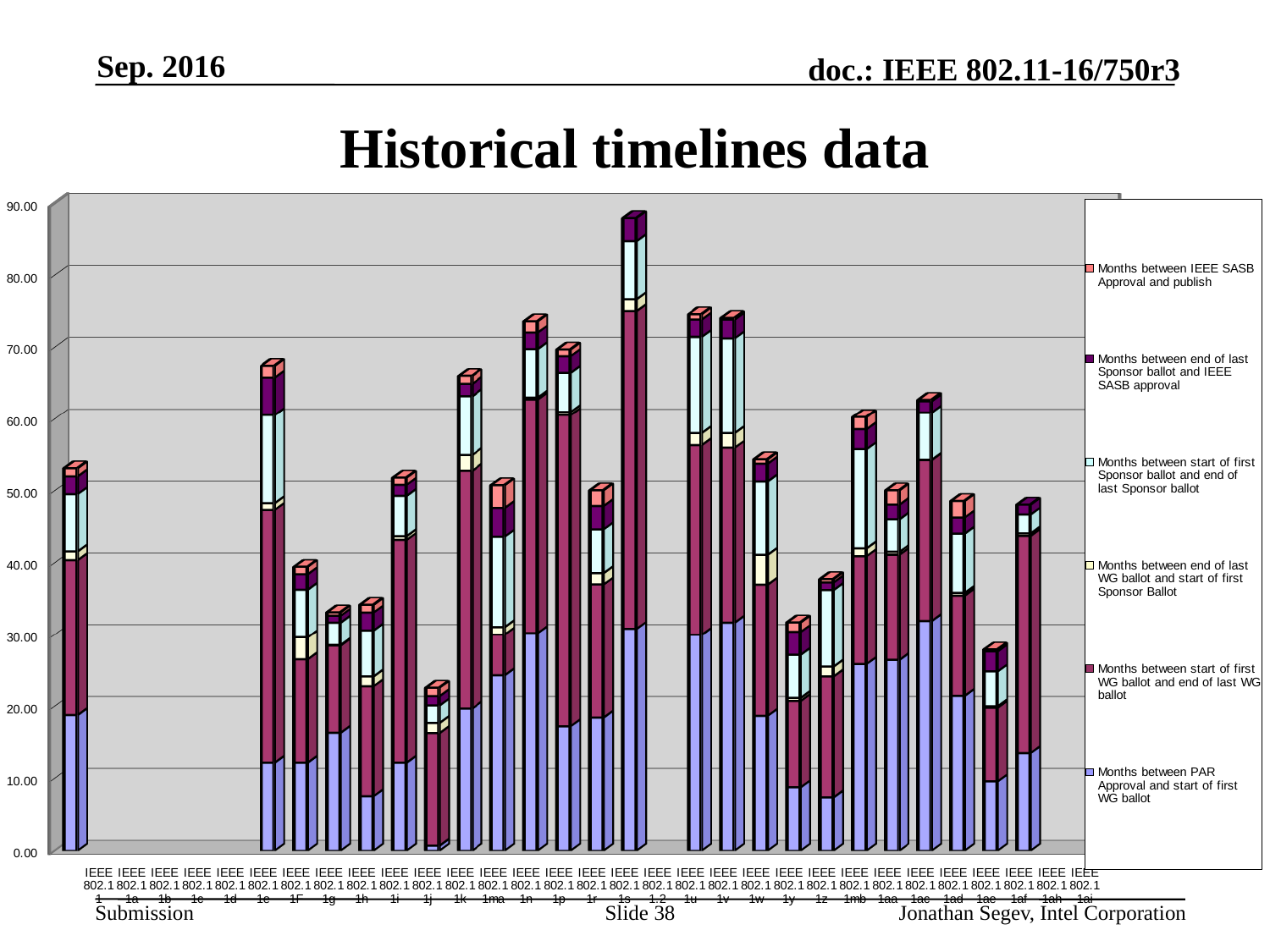
How many categories are labelled along the x axis? 31 What kind of chart is shown on the slide? Stacked bar chart Is the total for IEEE 802.1 1F greater or less than 60? less What is the highest value shown on the y axis? 90.00 How many series does the legend list? 6 Which category has the tallest stacked bar? IEEE 802.11s Which legend entry corresponds to the bottom segment of each stacked bar? Months between PAR Approval and start of first WG ballot What is the title of the chart? Historical timelines data Which has the taller stacked bar, IEEE 802.1 1F or IEEE 802.1 1g? IEEE 802.1 1F Is the total for IEEE 802.1 1k greater or less than 30? greater Is the total for IEEE 802.1 1h greater or less than 40? less